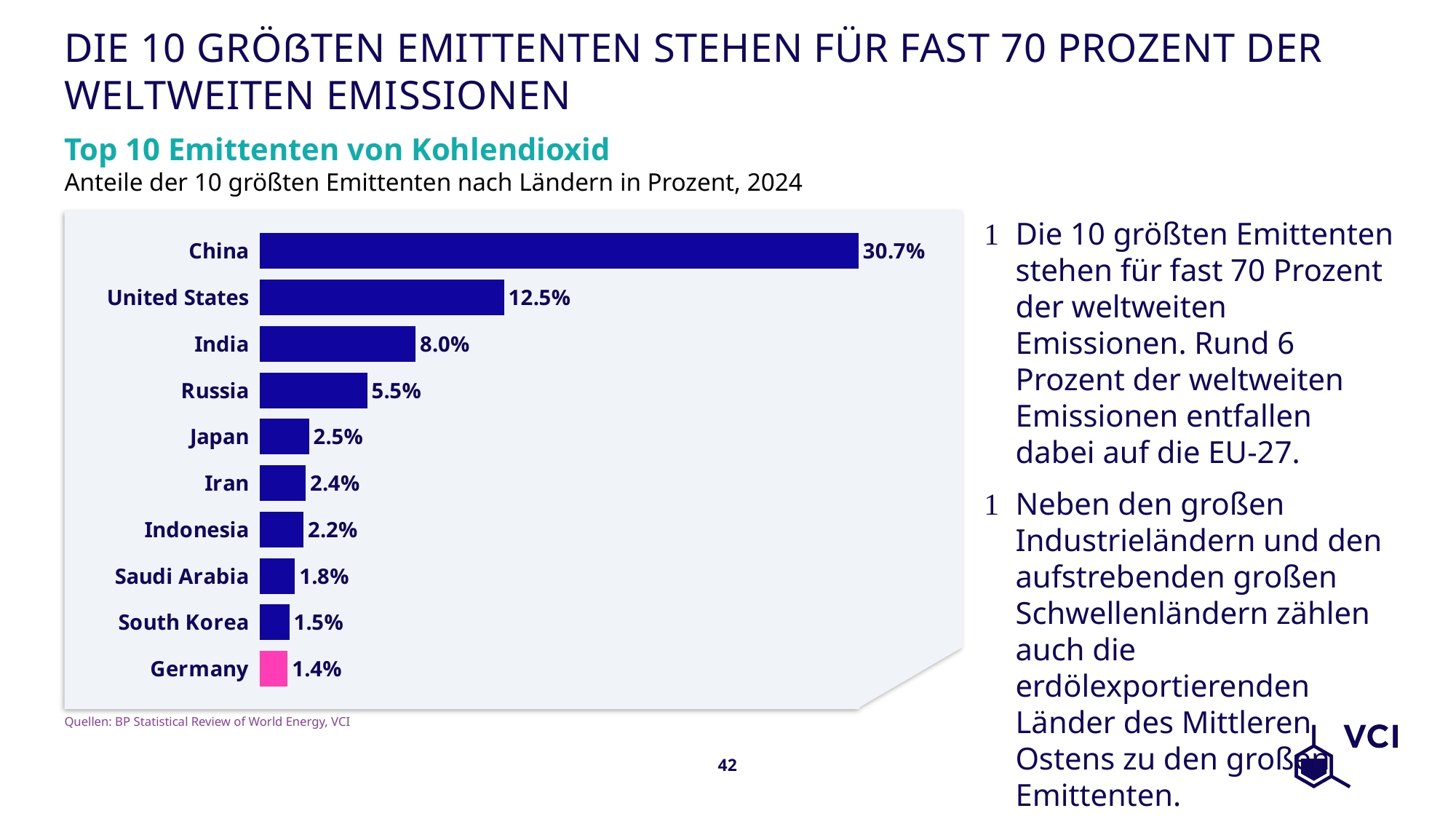
Which country's bar is shown in a different colour (pink) from the others? Germany How many countries are shown in the chart? 10 What is the value for Germany? 1.4% What is the value for India? 8.0% Which country has the lowest share? Germany What kind of chart is this? Bar chart What is the title of the chart? Top 10 Emittenten von Kohlendioxid What is the difference between the values for Russia and Japan? 3.0% Which is larger, the value for Iran or the value for Indonesia? Iran Which country has the highest share? China What is the difference between the values for China and the United States? 18.2% What is the value for China? 30.7%